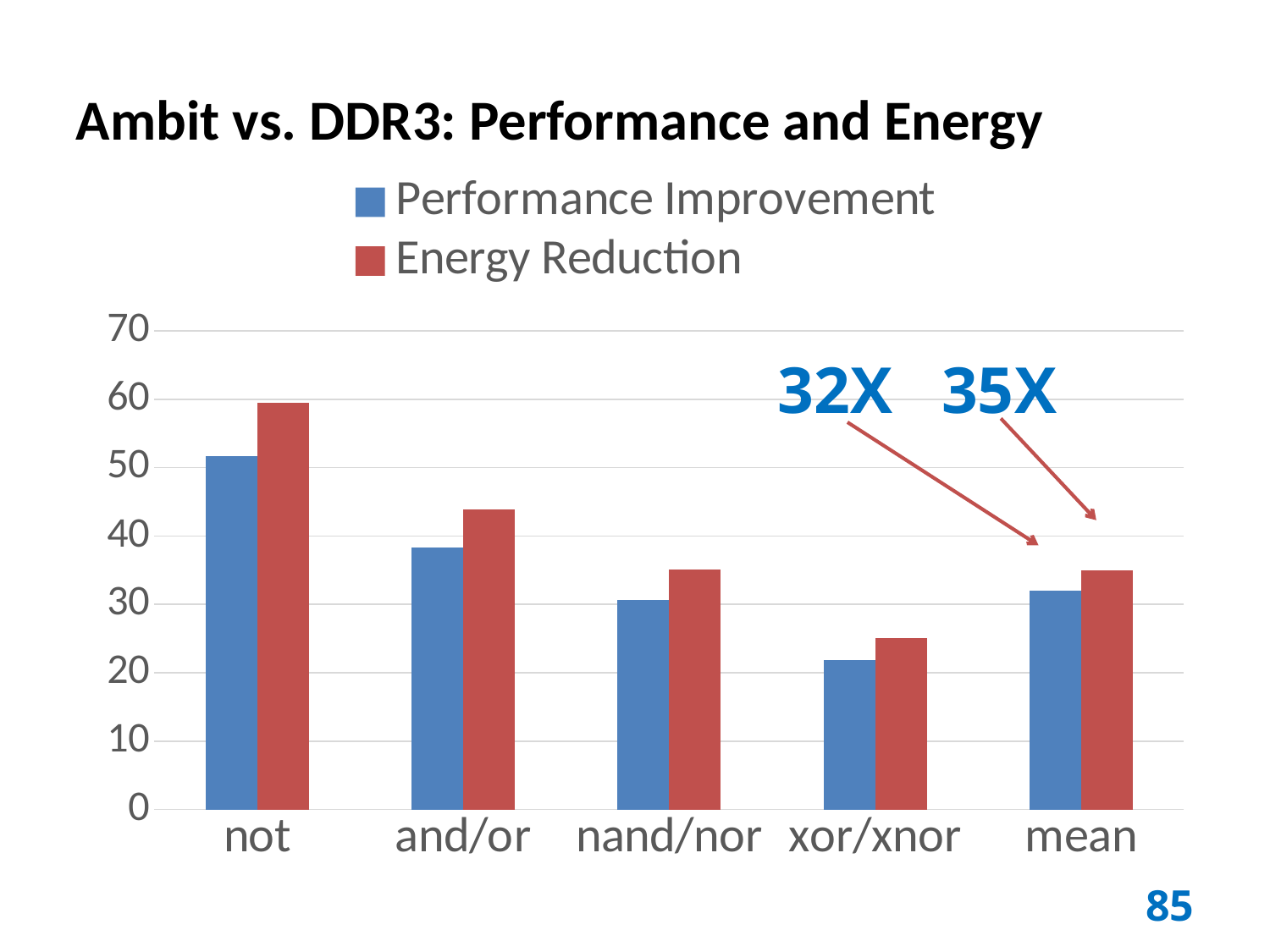
Is the Energy Reduction value for and/or greater or less than 40? greater Is the Performance Improvement value for not greater or less than 50? greater How many categories are shown on the x axis? 5 What is the Performance Improvement value for mean, as annotated on the chart? 32X Which category has the highest Performance Improvement? not For and/or, which is larger: Performance Improvement or Energy Reduction? Energy Reduction Is the Performance Improvement value for xor/xnor greater or less than 30? less Which category has the lowest Energy Reduction? xor/xnor How many series does the legend list? 2 What type of chart is shown on the slide? bar chart What is the Energy Reduction value for mean, as annotated on the chart? 35X Do the Energy Reduction values rise or fall from not to xor/xnor? fall